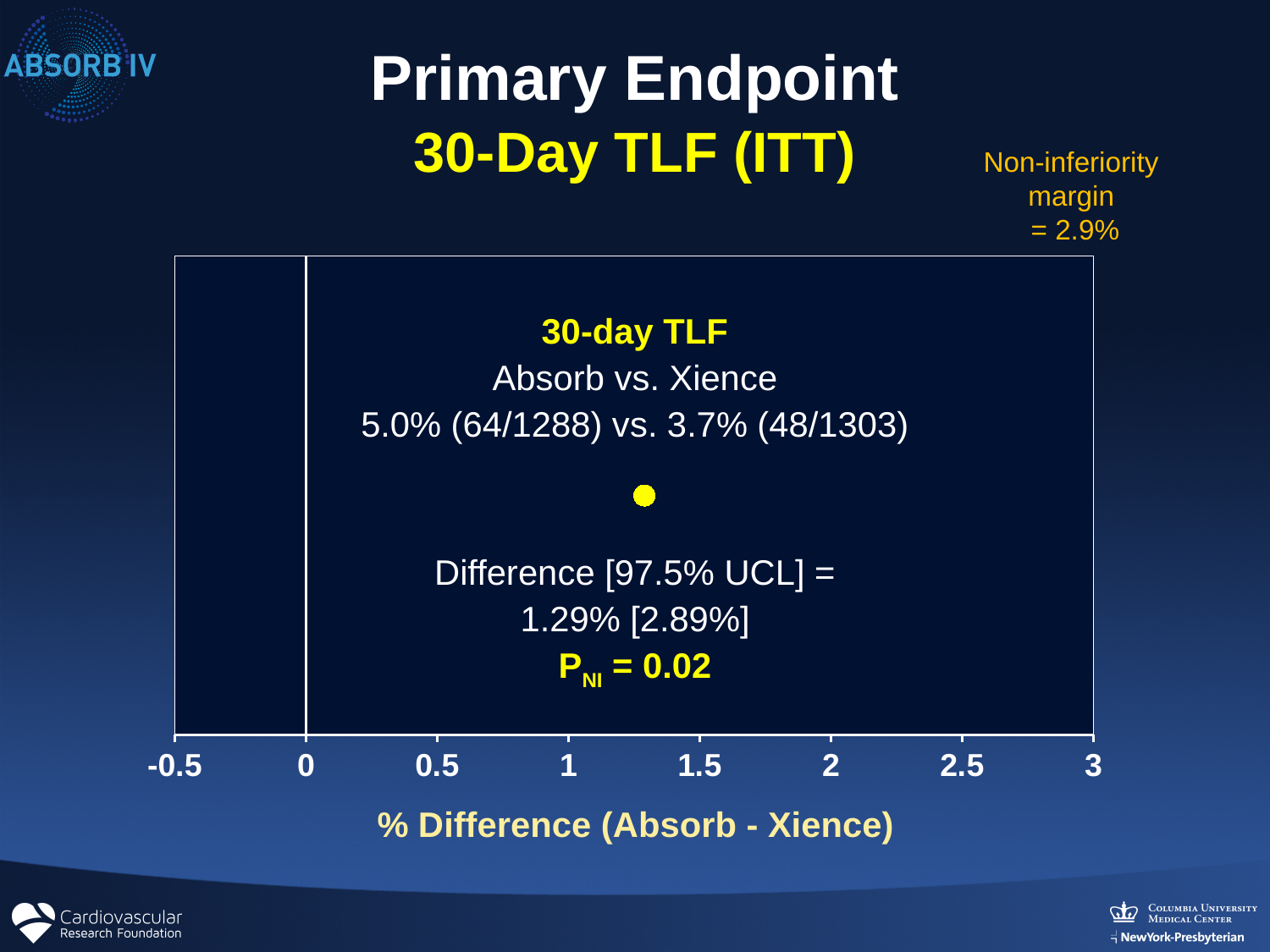
What is the difference in 30-day TLF between Absorb and Xience shown on the chart? 1.29% Is the plotted point for the % difference greater or less than 1 on the x axis? greater Which group has the higher 30-day TLF rate, Absorb or Xience? Absorb What is the highest value shown on the x axis of the chart? 3 Is the plotted point for the % difference greater or less than 1.5 on the x axis? less What is the non-inferiority p-value shown on the chart? 0.02 What is the non-inferiority margin stated on the slide? 2.9% How many data points are plotted on the chart? 1 What is the 30-day TLF rate for Xience shown on the chart? 3.7% What is the 30-day TLF rate for Absorb shown on the chart? 5.0% What is the 97.5% upper confidence limit (UCL) for the difference shown on the chart? 2.89% What is the label of the x axis on the chart? % Difference (Absorb - Xience)